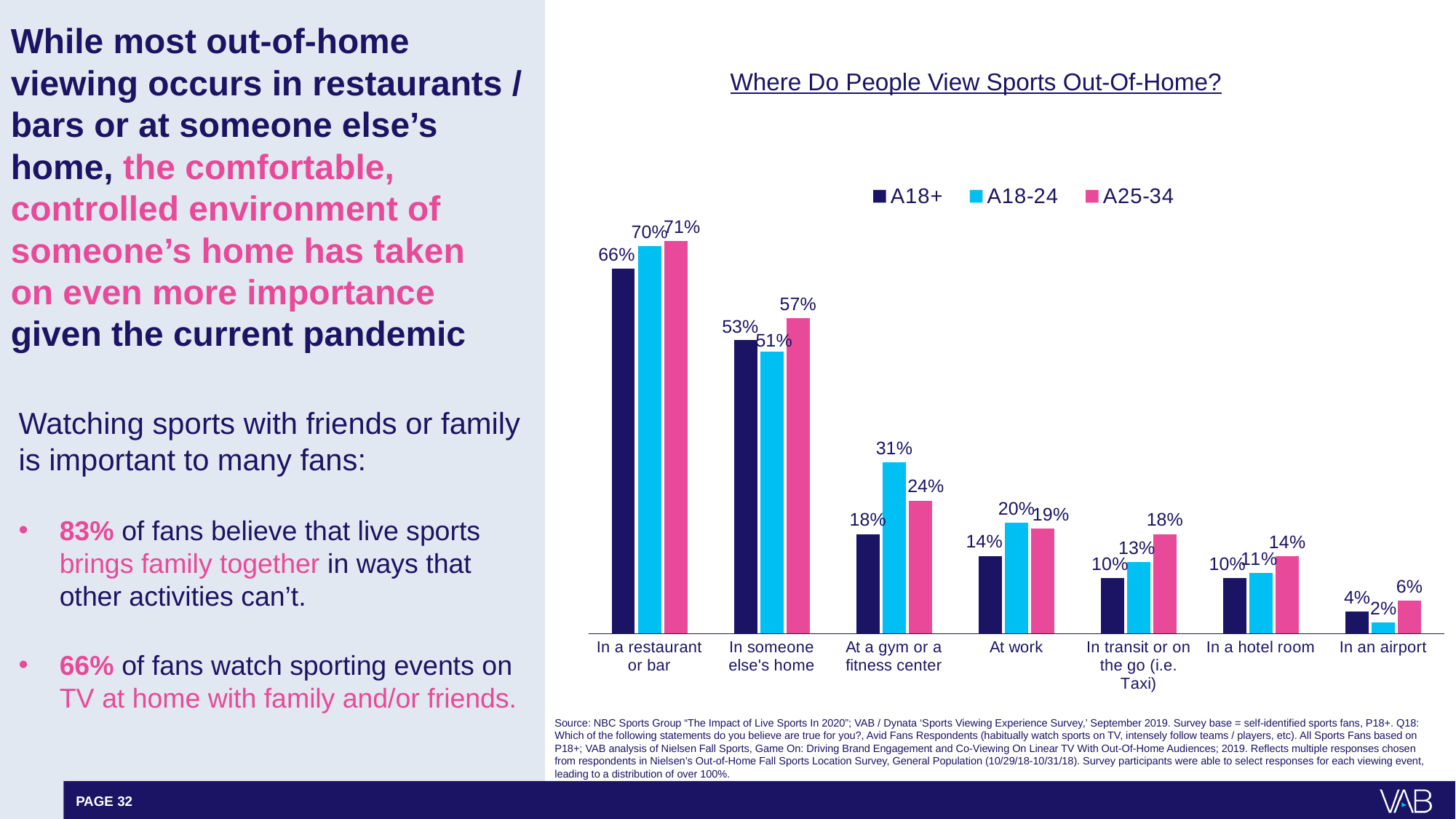
What is the A18-24 value for 'At a gym or a fitness center'? 31% What is the chart's title? Where Do People View Sports Out-Of-Home? What is the difference between the A18-24 and A18+ values for 'At a gym or a fitness center'? 13% What is the A25-34 value for 'In someone else's home'? 57% What is the A18+ value for 'In transit or on the go (i.e. Taxi)'? 10% Which location has the lowest A18-24 value? In an airport What kind of chart is shown on the slide? bar chart For 'In transit or on the go (i.e. Taxi)', which series has the larger value, A18-24 or A25-34? A25-34 Which location has the highest A18+ value? In a restaurant or bar How many location categories are shown on the x axis? 7 Do the A18+ values rise or fall moving from left to right across the categories? fall How many series does the legend list? 3